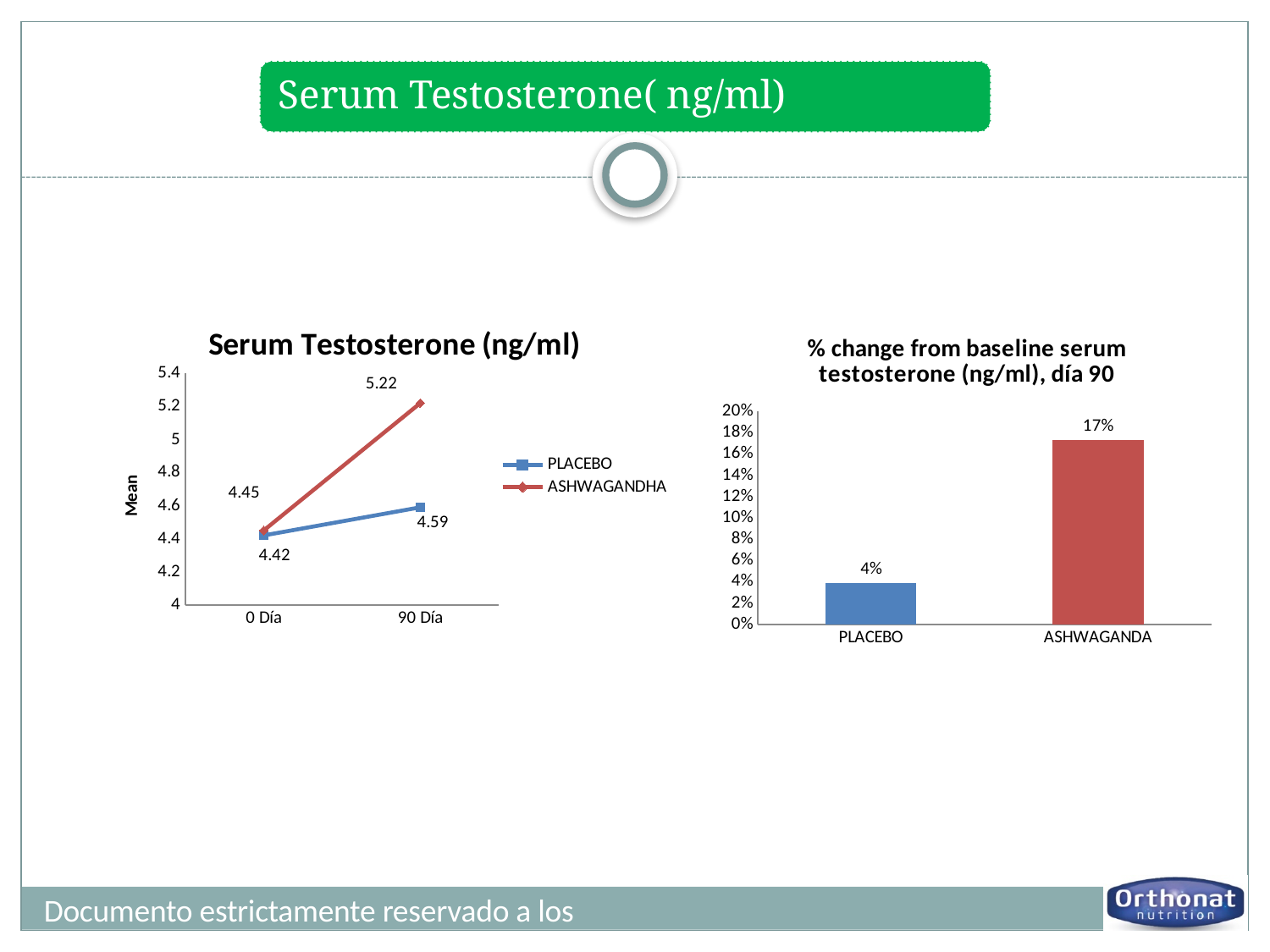
In the 'Serum Testosterone (ng/ml)' line chart, what is the value for PLACEBO at 90 Día? 4.59 In the '% change from baseline serum testosterone (ng/ml), día 90' chart, what is the difference between the ASHWAGANDA and PLACEBO values? 13% In the 'Serum Testosterone (ng/ml)' line chart, does the ASHWAGANDHA series rise or fall from 0 Día to 90 Día? rise In the 'Serum Testosterone (ng/ml)' line chart, what is the value for ASHWAGANDHA at 0 Día? 4.45 In the '% change from baseline serum testosterone (ng/ml), día 90' chart, what is the value for PLACEBO? 4% In the '% change from baseline serum testosterone (ng/ml), día 90' chart, what kind of chart is it? bar chart In the 'Serum Testosterone (ng/ml)' line chart, what is the value for PLACEBO at 0 Día? 4.42 In the 'Serum Testosterone (ng/ml)' line chart, what is the label of the y axis? Mean In the 'Serum Testosterone (ng/ml)' line chart, what is the difference between the ASHWAGANDHA and PLACEBO values at 90 Día? 0.63 In the 'Serum Testosterone (ng/ml)' line chart, what is the value for ASHWAGANDHA at 90 Día? 5.22 In the '% change from baseline serum testosterone (ng/ml), día 90' chart, what is the value for ASHWAGANDA? 17% In the 'Serum Testosterone (ng/ml)' line chart, how many series does the legend list? 2